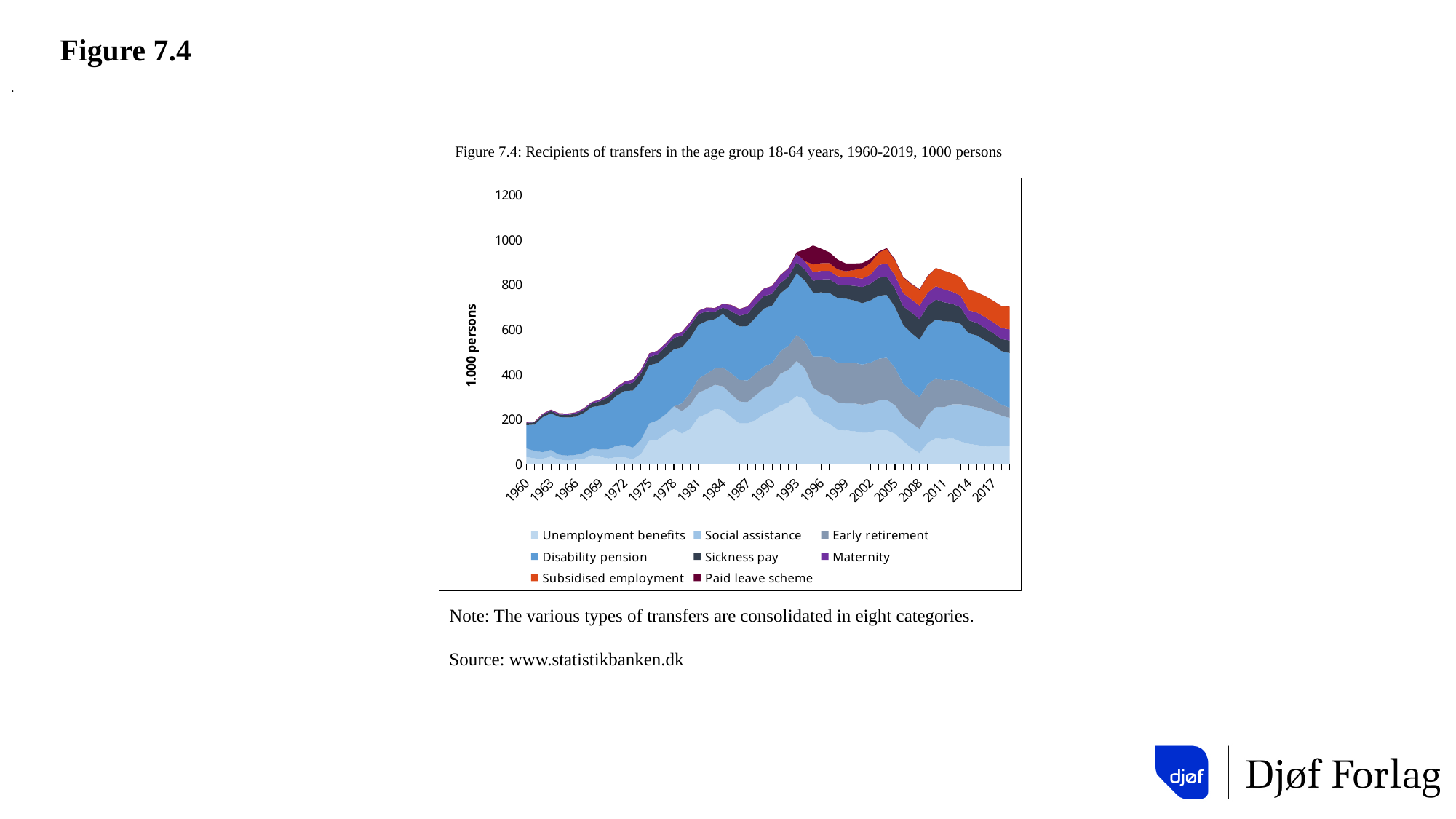
Is the total number of recipients in 1993 greater or less than 800? greater Is the total number of recipients in 1969 greater or less than 400? less What is the title of the chart? Figure 7.4: Recipients of transfers in the age group 18-64 years, 1960-2019, 1000 persons Is the total number of recipients in 1960 greater or less than 400? less Does the total number of recipients rise or fall between 1960 and 1993? Rise How many year labels are shown on the x axis? 20 Does the total number of recipients rise or fall between 2005 and 2019? Fall What is the label on the vertical axis? 1.000 persons What kind of chart is shown on the slide? Stacked area chart How many series does the legend list? 8